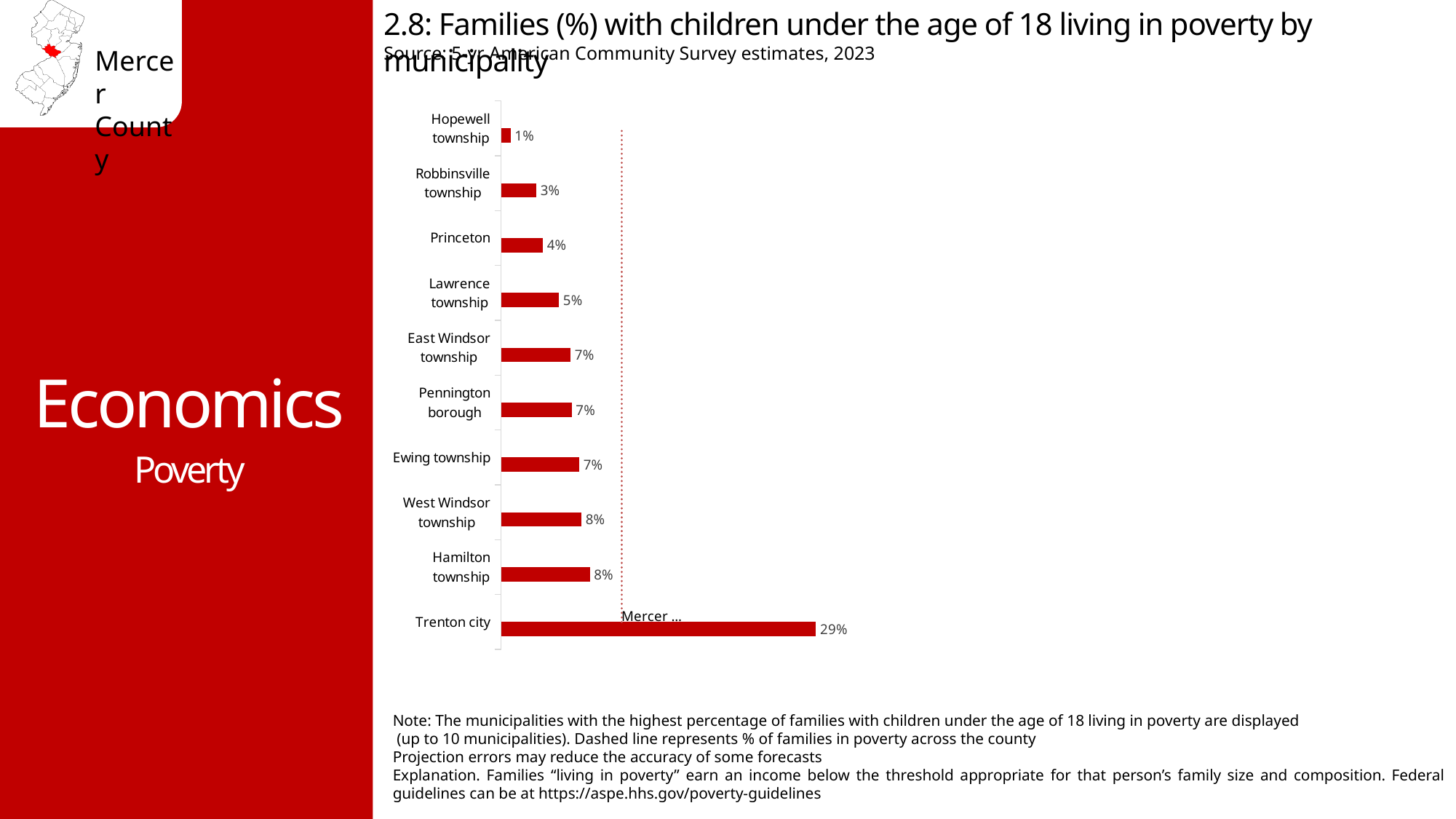
What is the difference between the values for West Windsor township and Robbinsville township? 5% What is the value for Trenton city? 29% What is the difference between the values for Trenton city and Hamilton township? 21% What does the dashed line in the chart represent? % of families in poverty across the county What kind of chart is shown on the slide? Bar chart What is the value for Princeton? 4% Which is larger, the value for Ewing township or the value for Princeton? Ewing township What is the value for Lawrence township? 5% Which municipality has the lowest percentage of families with children under 18 living in poverty? Hopewell township What is the value for Hopewell township? 1% Which municipality has the highest percentage of families with children under 18 living in poverty? Trenton city How many municipalities are shown in the chart? 10